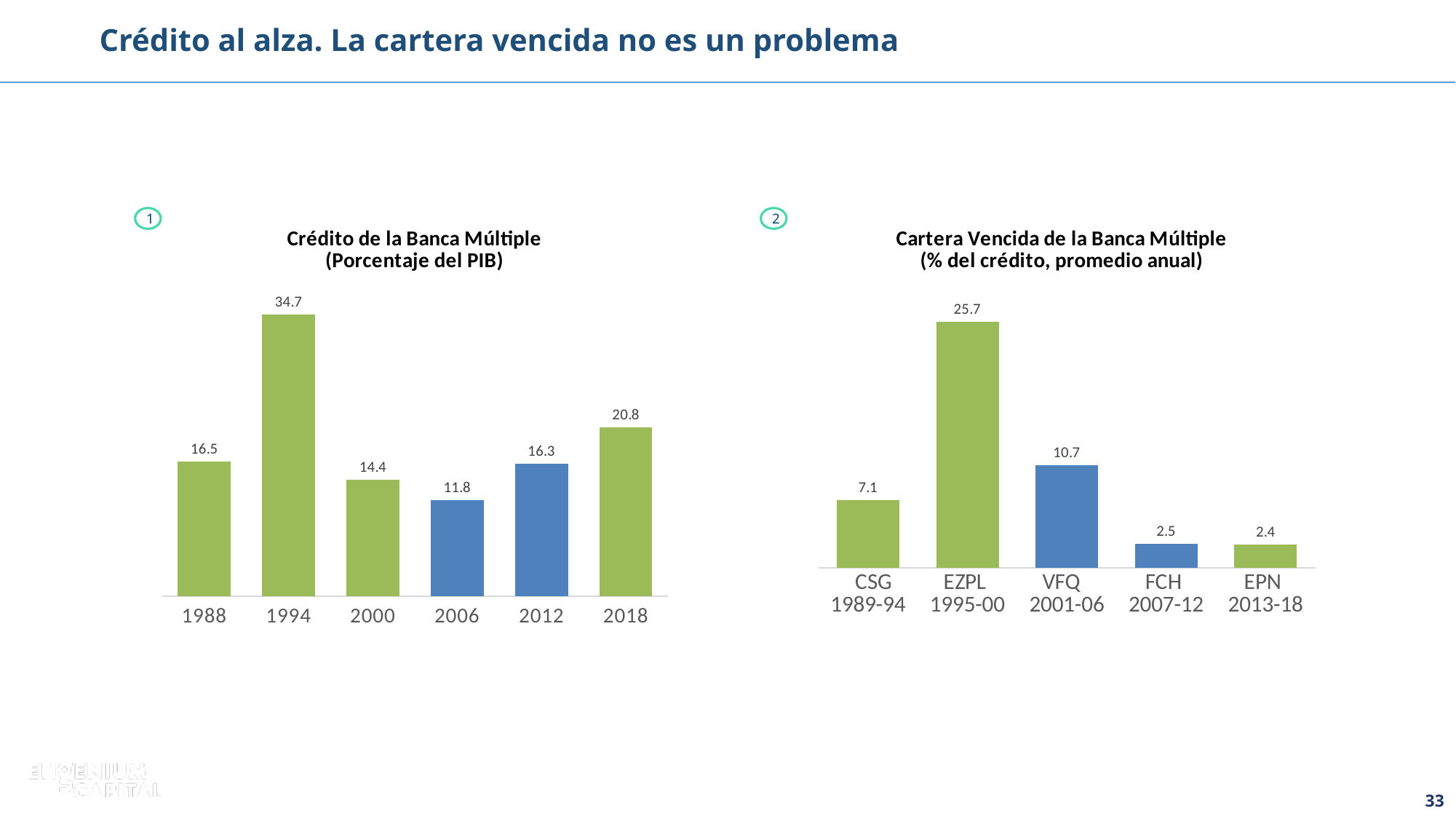
In the 'Crédito de la Banca Múltiple' chart, what is the value for 1994? 34.7 What kind of chart is the 'Crédito de la Banca Múltiple' chart? Bar chart In the 'Cartera Vencida de la Banca Múltiple' chart, which period has the highest value? EZPL 1995-00 What is the subtitle in parentheses of the 'Cartera Vencida de la Banca Múltiple' chart? (% del crédito, promedio anual) In the 'Cartera Vencida de la Banca Múltiple' chart, what is the value for VFQ 2001-06? 10.7 In the 'Crédito de la Banca Múltiple' chart, what is the difference between the values for 2018 and 2012? 4.5 How many years are shown in the 'Crédito de la Banca Múltiple' chart? 6 In the 'Cartera Vencida de la Banca Múltiple' chart, what is the difference between the values for EZPL 1995-00 and CSG 1989-94? 18.6 In the 'Crédito de la Banca Múltiple' chart, which year has the lowest value? 2006 In the 'Cartera Vencida de la Banca Múltiple' chart, do the values rise or fall from VFQ 2001-06 to EPN 2013-18? Fall How many periods are shown in the 'Cartera Vencida de la Banca Múltiple' chart? 5 In the 'Crédito de la Banca Múltiple' chart, which is larger, the value for 1988 or the value for 2000? 1988